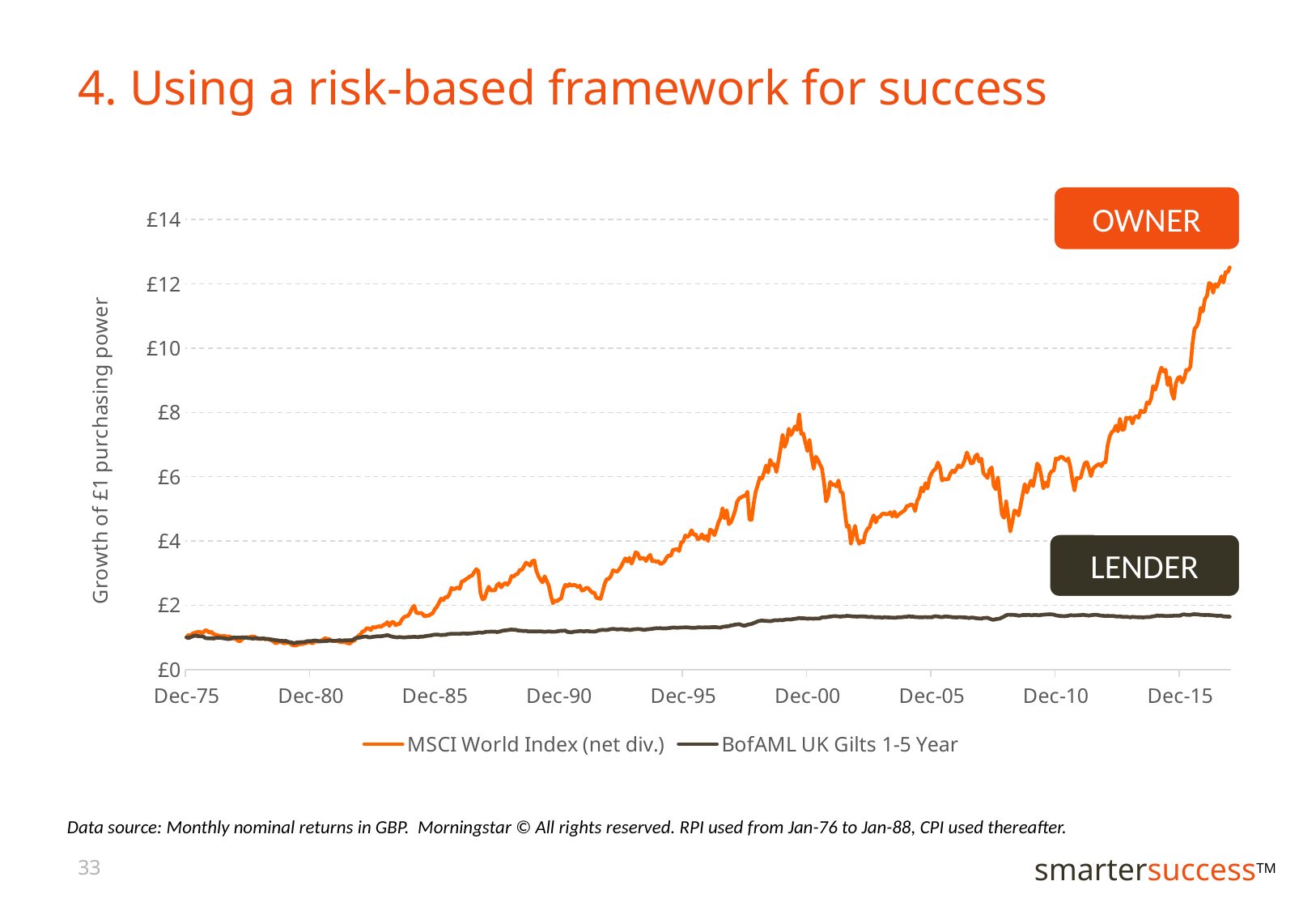
What kind of chart is shown on the slide? Line chart Is the value of the MSCI World Index (net div.) line at its final point greater or less than £10? greater Which series has the higher value at Dec-15, MSCI World Index (net div.) or BofAML UK Gilts 1-5 Year? MSCI World Index (net div.) How many series does the legend list? 2 Which series is drawn in orange? MSCI World Index (net div.) How many labelled tick marks are on the x axis? 9 Is the value of the BofAML UK Gilts 1-5 Year line at Dec-15 greater or less than £2? less Is the value of the MSCI World Index (net div.) line at Dec-95 greater or less than £2? greater What is the title of the vertical axis? Growth of £1 purchasing power Does the MSCI World Index (net div.) line overall rise or fall from Dec-75 to the end of the chart? rise